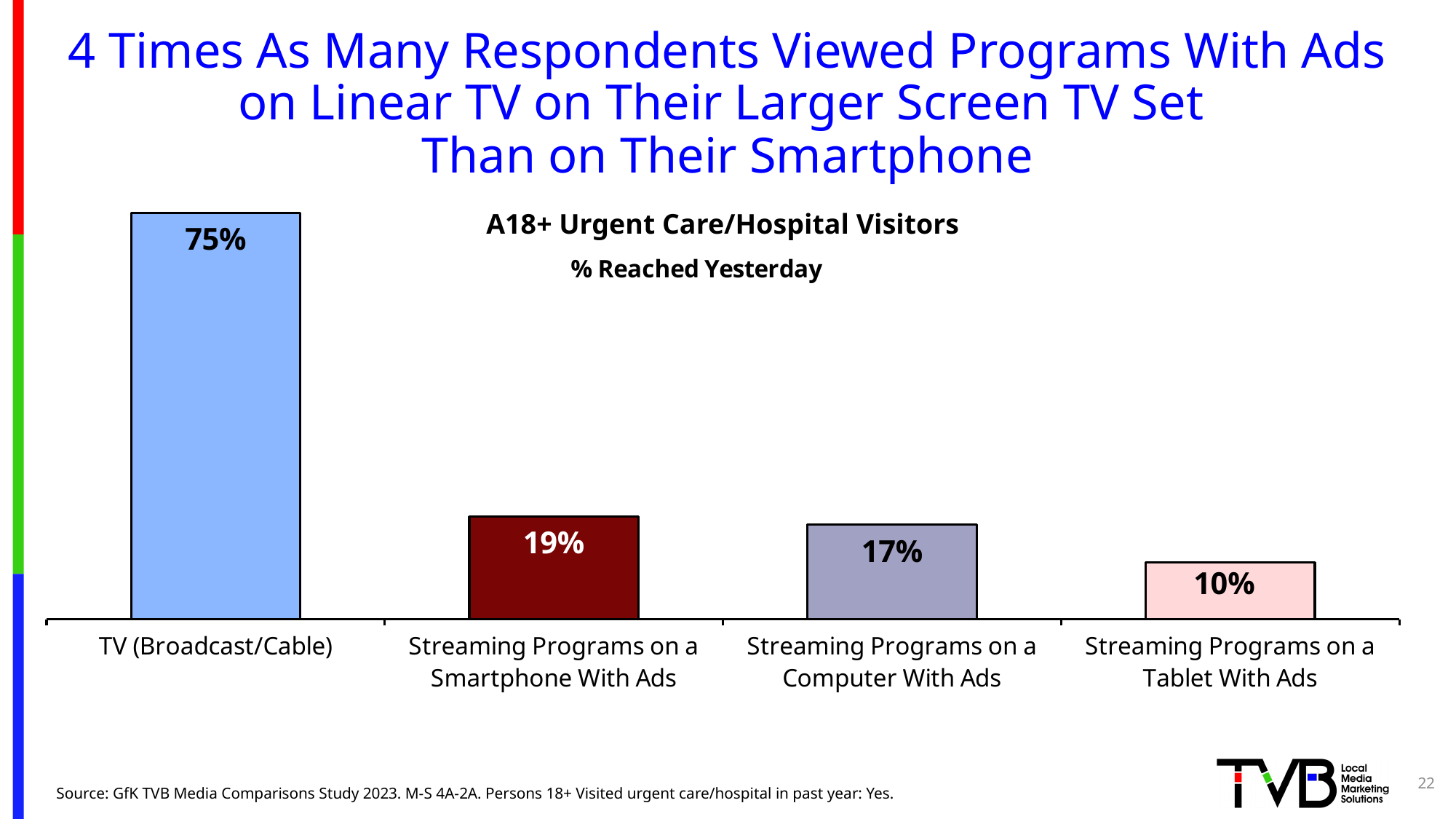
What is the difference between Streaming Programs on a Computer With Ads and Streaming Programs on a Tablet With Ads? 7 percentage points Which is larger: Streaming Programs on a Smartphone With Ads or Streaming Programs on a Computer With Ads? Streaming Programs on a Smartphone With Ads What is the title of the chart? A18+ Urgent Care/Hospital Visitors Which category has the highest % reached yesterday? TV (Broadcast/Cable) What is the value for Streaming Programs on a Smartphone With Ads? 19% What is the value for Streaming Programs on a Tablet With Ads? 10% What is the value for Streaming Programs on a Computer With Ads? 17% Which category has the lowest % reached yesterday? Streaming Programs on a Tablet With Ads What percentage of A18+ urgent care/hospital visitors were reached yesterday by TV (Broadcast/Cable)? 75% What kind of chart is shown on the slide? Bar chart What is the difference in percentage points between TV (Broadcast/Cable) and Streaming Programs on a Smartphone With Ads? 56 percentage points How many categories are shown in the chart? 4